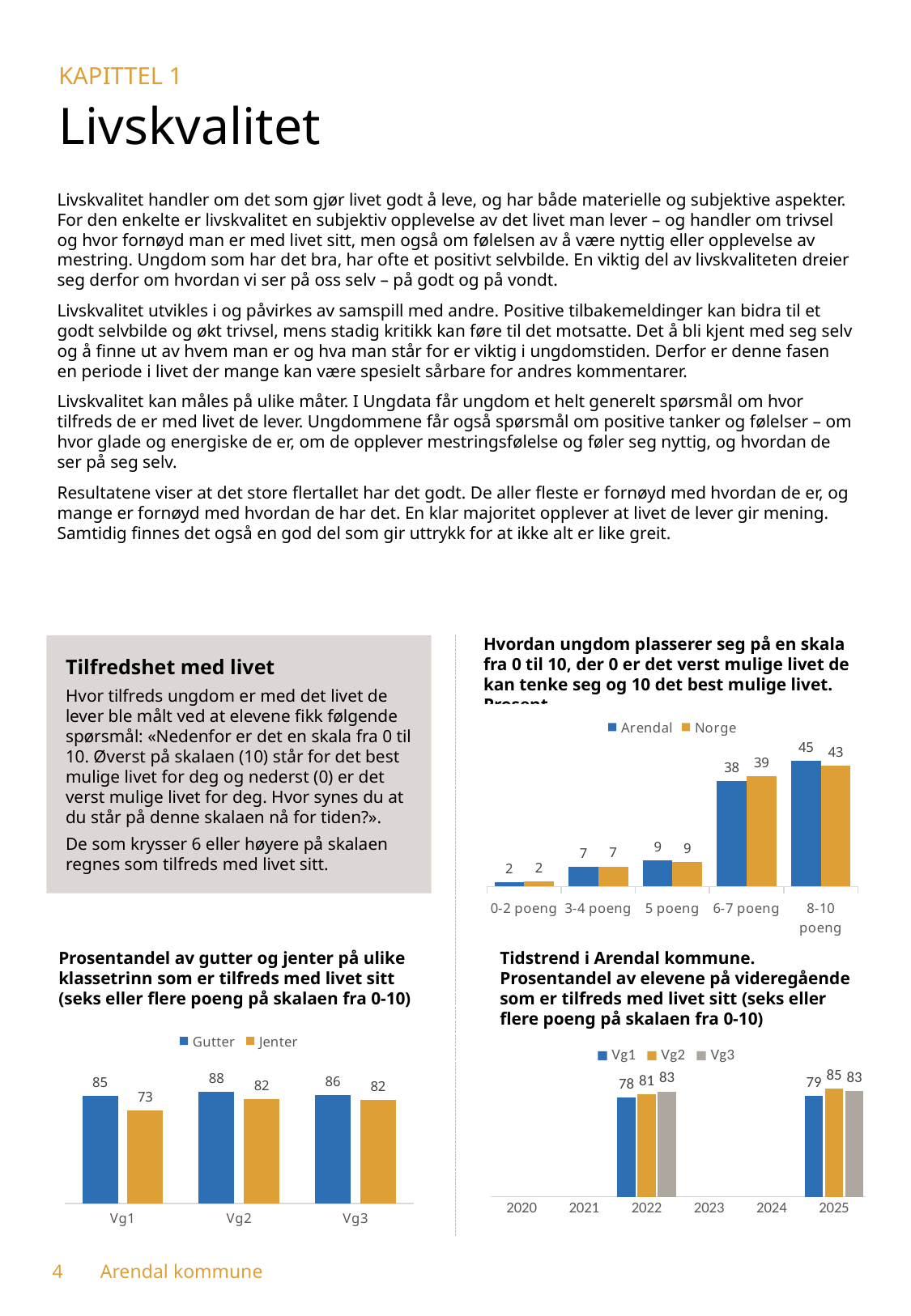
In the bottom-left chart (Prosentandel av gutter og jenter på ulike klassetrinn som er tilfreds med livet sitt), what is the difference between Gutter and Jenter at Vg1? 12 In the top-right chart (Hvordan ungdom plasserer seg på en skala fra 0 til 10), what is the value for Arendal in the 8-10 poeng category? 45 In the bottom-right chart (Tidstrend i Arendal kommune), what is the value for Vg2 in 2025? 85 In the bottom-left chart (Prosentandel av gutter og jenter på ulike klassetrinn som er tilfreds med livet sitt), which series does the legend list first? Gutter In the top-right chart (Hvordan ungdom plasserer seg på en skala fra 0 til 10), how many categories are shown on the x axis? 5 In the top-right chart (Hvordan ungdom plasserer seg på en skala fra 0 til 10), which category has the lowest value for Arendal? 0-2 poeng In the bottom-right chart (Tidstrend i Arendal kommune), how many series does the legend list? 3 In the bottom-left chart (Prosentandel av gutter og jenter på ulike klassetrinn som er tilfreds med livet sitt), which class level has the highest value for Gutter? Vg2 In the bottom-left chart (Prosentandel av gutter og jenter på ulike klassetrinn som er tilfreds med livet sitt), what is the value for Jenter at Vg1? 73 In the top-right chart (Hvordan ungdom plasserer seg på en skala fra 0 til 10), what is the difference between Arendal and Norge in the 8-10 poeng category? 2 In the bottom-right chart (Tidstrend i Arendal kommune), is the value for Vg1 in 2022 larger or smaller than the value for Vg3 in 2022? smaller In the top-right chart (Hvordan ungdom plasserer seg på en skala fra 0 til 10), what is the value for Norge in the 6-7 poeng category? 39